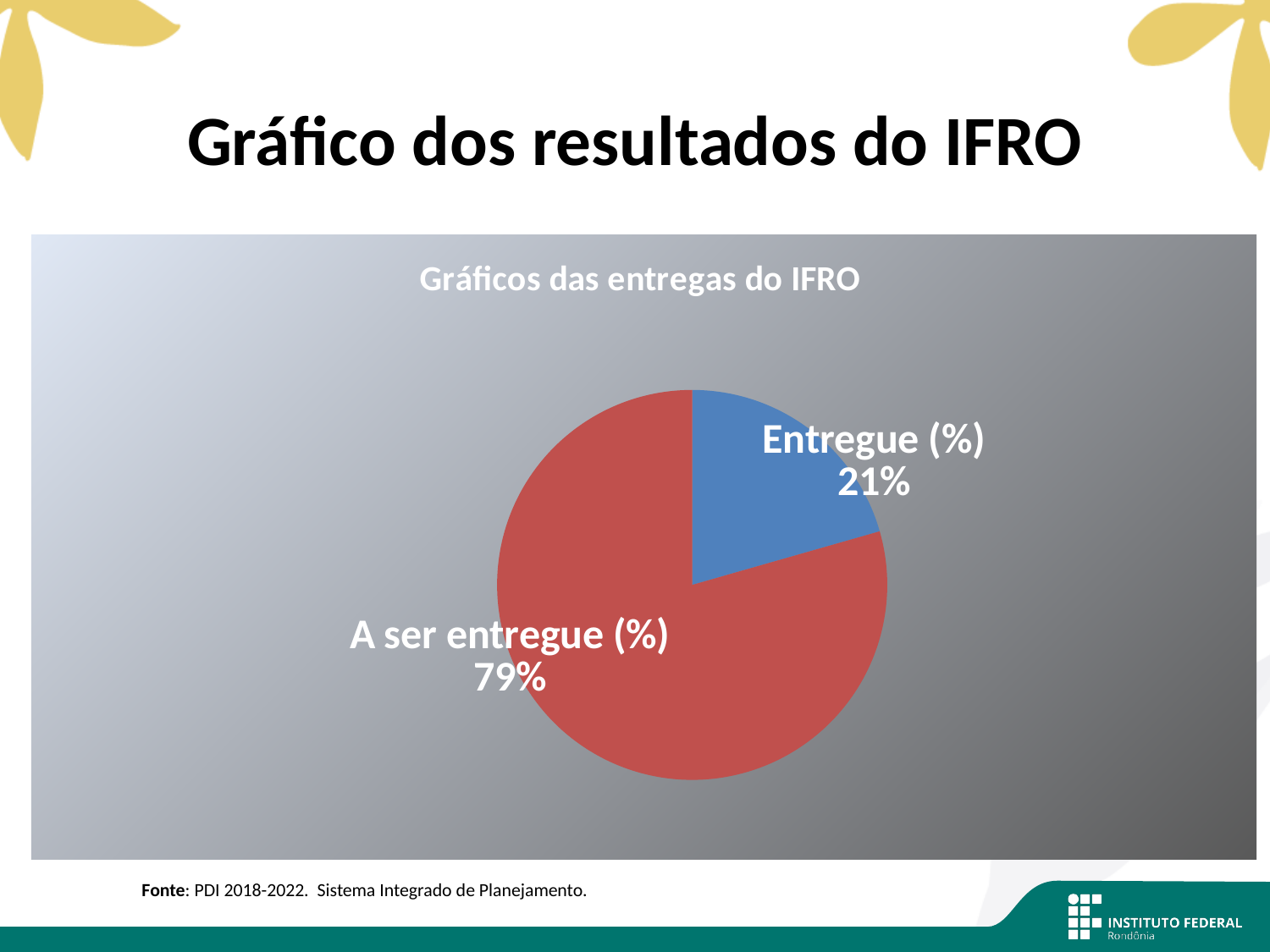
What is the title of the chart? Gráficos das entregas do IFRO Which is larger, "Entregue (%)" or "A ser entregue (%)"? A ser entregue (%) Which slice is the smallest? Entregue (%) How many slices does the pie chart have? 2 Which slice is the largest? A ser entregue (%) What is the value for "A ser entregue (%)"? 79% What share of the pie does the "Entregue (%)" slice represent? 21% What is the difference between the "A ser entregue (%)" and "Entregue (%)" values? 58% What colour is the "A ser entregue (%)" slice? red What kind of chart is shown on the slide? pie chart What is the value for "Entregue (%)"? 21%